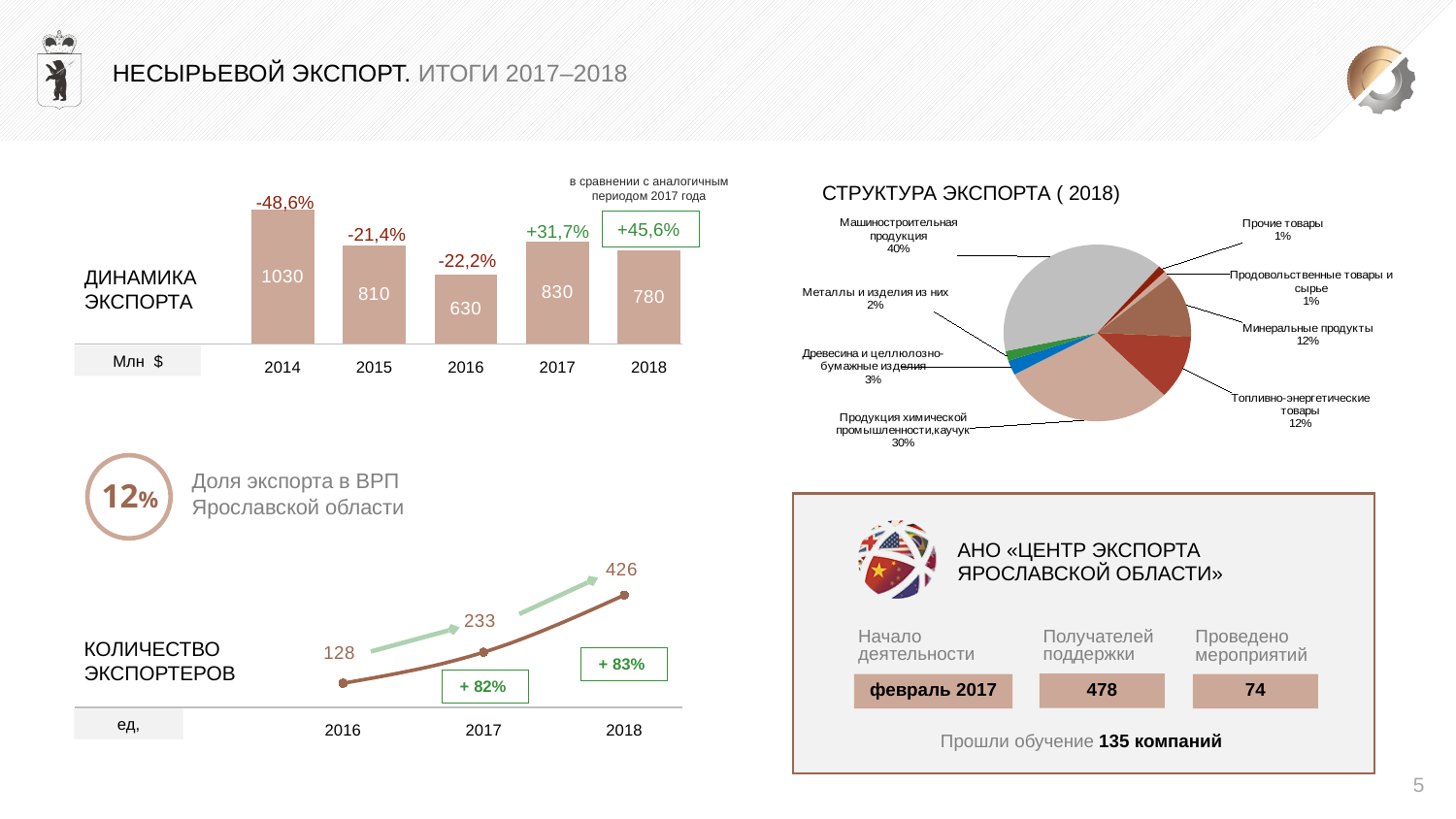
In the 'КОЛИЧЕСТВО ЭКСПОРТЕРОВ' line chart, what is the value for 2018? 426 In the 'КОЛИЧЕСТВО ЭКСПОРТЕРОВ' line chart, do the values rise or fall from 2016 to 2018? Rise In the 'ДИНАМИКА ЭКСПОРТА' bar chart, which year has the lowest value? 2016 In the 'СТРУКТУРА ЭКСПОРТА (2018)' pie chart, what share does 'Продукция химической промышленности, каучук' have? 30% In the 'ДИНАМИКА ЭКСПОРТА' bar chart, what percentage change is shown above the 2018 bar? +45,6% In the 'ДИНАМИКА ЭКСПОРТА' bar chart, what is the value for 2014? 1030 In the 'ДИНАМИКА ЭКСПОРТА' bar chart, what is the difference between the values for 2017 and 2018? 50 In the 'СТРУКТУРА ЭКСПОРТА (2018)' pie chart, what share does 'Машиностроительная продукция' have? 40% What kind of chart is 'СТРУКТУРА ЭКСПОРТА (2018)'? Pie chart In the 'ДИНАМИКА ЭКСПОРТА' bar chart, which year has the highest value? 2014 In the 'КОЛИЧЕСТВО ЭКСПОРТЕРОВ' line chart, what is the difference between the values for 2017 and 2016? 105 How many years are shown in the 'ДИНАМИКА ЭКСПОРТА' bar chart? 5